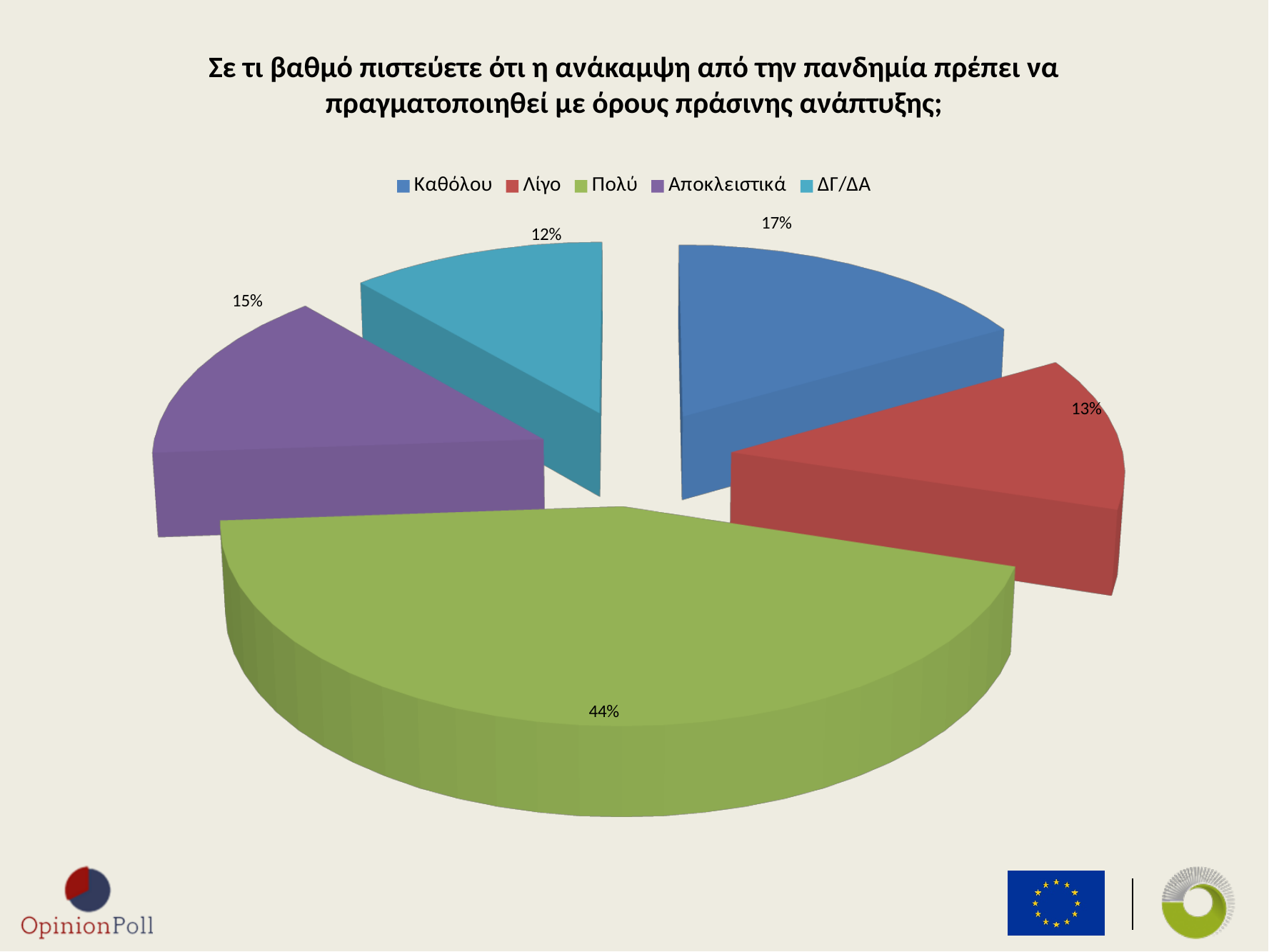
What kind of chart is shown on the slide? Pie chart Which response category has the smallest share of the pie? ΔΓ/ΔΑ What percentage of respondents answered Καθόλου? 17% What is the difference in percentage points between Πολύ and Καθόλου? 27 What percentage of respondents answered Λίγο? 13% What colour is the slice for Πολύ? Green Which is larger, the share for Αποκλειστικά or the share for Λίγο? Αποκλειστικά What percentage of respondents answered Αποκλειστικά? 15% How many categories does the legend list? 5 What percentage of respondents answered ΔΓ/ΔΑ? 12% Which response category has the largest share of the pie? Πολύ What percentage of respondents answered Πολύ? 44%